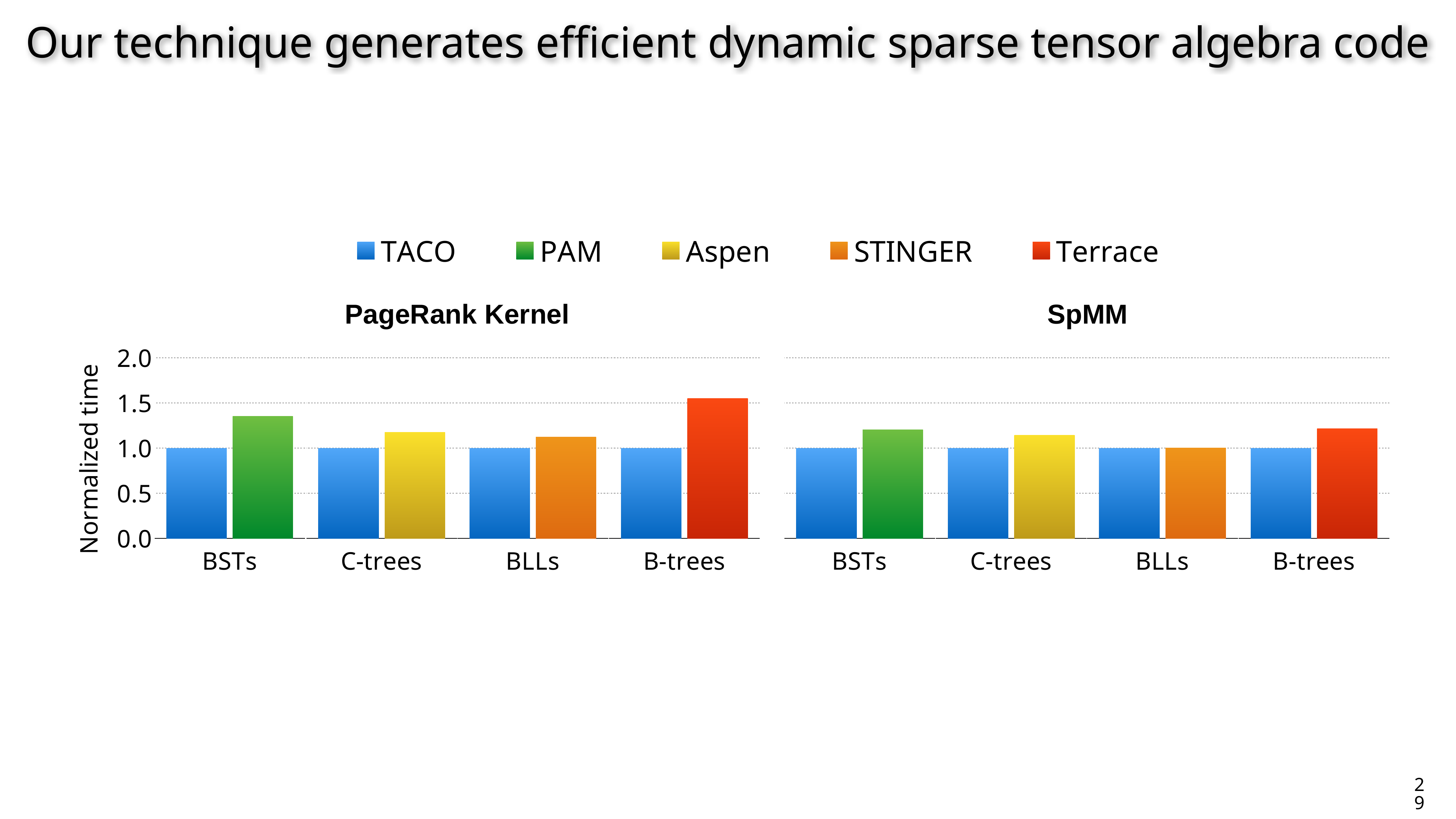
In the PageRank Kernel chart, is the value for Terrace at B-trees greater or less than 1.0? greater In the SpMM chart, is the value for PAM at BSTs greater or less than 1.5? less How many series does the legend list? 5 How many categories are shown on the x axis of the SpMM chart? 4 In the SpMM chart, what is the normalized time for STINGER at BLLs? 1.0 In the PageRank Kernel chart, which series has the highest bar? Terrace In the SpMM chart, which is larger: the Aspen bar at C-trees or the STINGER bar at BLLs? Aspen at C-trees In the PageRank Kernel chart, is the value for PAM at BSTs greater or less than 1.5? less In the PageRank Kernel chart, which is larger: the PAM bar at BSTs or the Aspen bar at C-trees? PAM at BSTs What kind of chart is the PageRank Kernel chart? bar chart In the PageRank Kernel chart, what is the normalized time for TACO at BSTs? 1.0 What is the label on the y axis of the charts? Normalized time